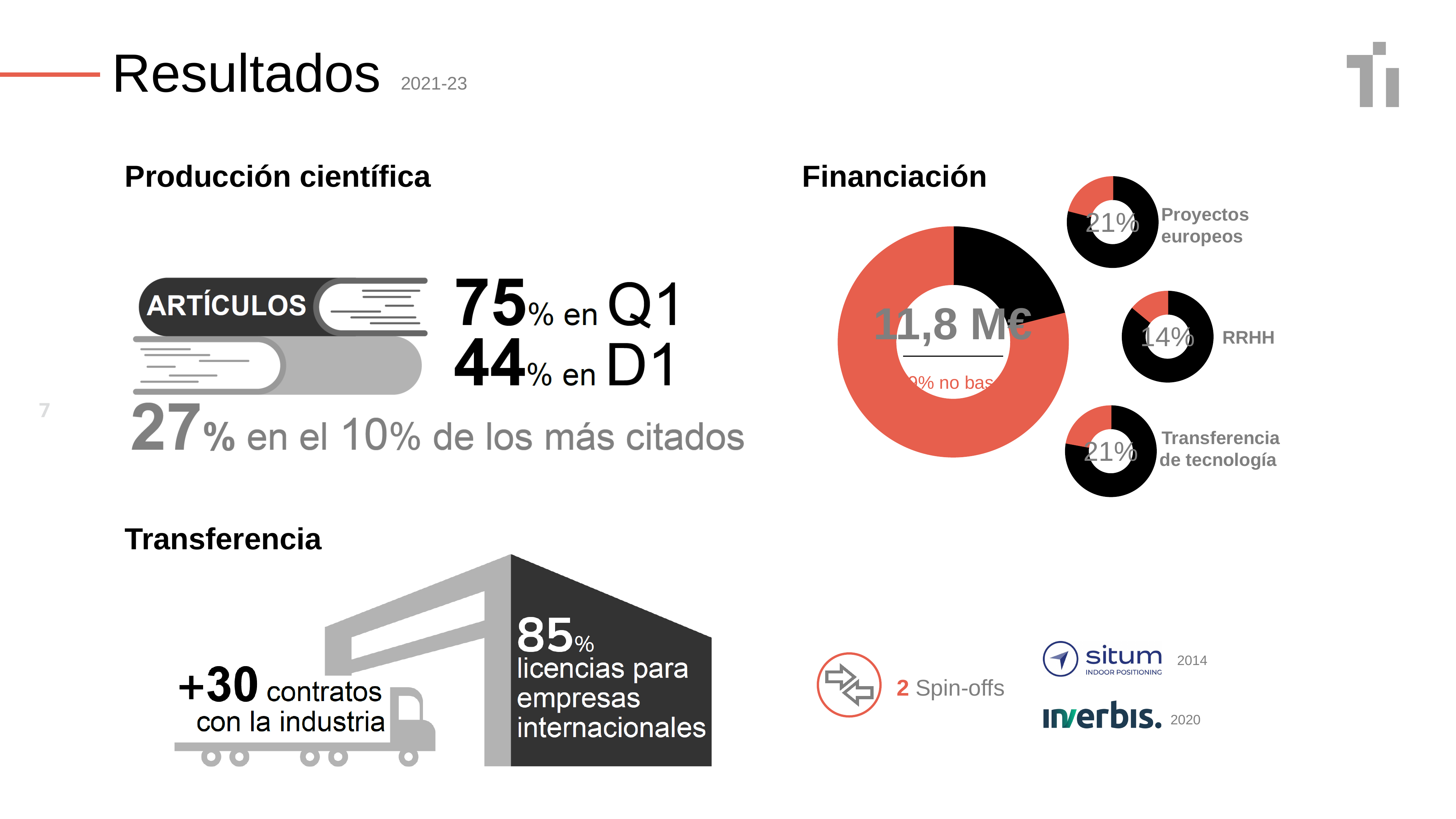
In the Financiación section, what is the difference in percentage points between Proyectos europeos and RRHH? 7 Among the three small donut charts in the Financiación section, which category has the lowest percentage? RRHH Which two categories in the small donut charts of the Financiación section show the same percentage? Proyectos europeos and Transferencia de tecnología What kind of chart is used in the Financiación section of the slide? donut chart In the Financiación section, what percentage is shown for Proyectos europeos? 21% In the Financiación section, which is larger: the percentage for Proyectos europeos or for RRHH? Proyectos europeos In the large donut chart in the Financiación section, which colour segment is larger, the red or the black? red In the Financiación section, what percentage is shown for Transferencia de tecnología? 21% In the large donut chart in the Financiación section, is the red segment's share greater or less than 50%? greater How many small donut charts are shown in the Financiación section? 3 What value is printed in the centre of the large donut chart in the Financiación section? 11,8 M€ In the Financiación section, what percentage is shown for RRHH? 14%